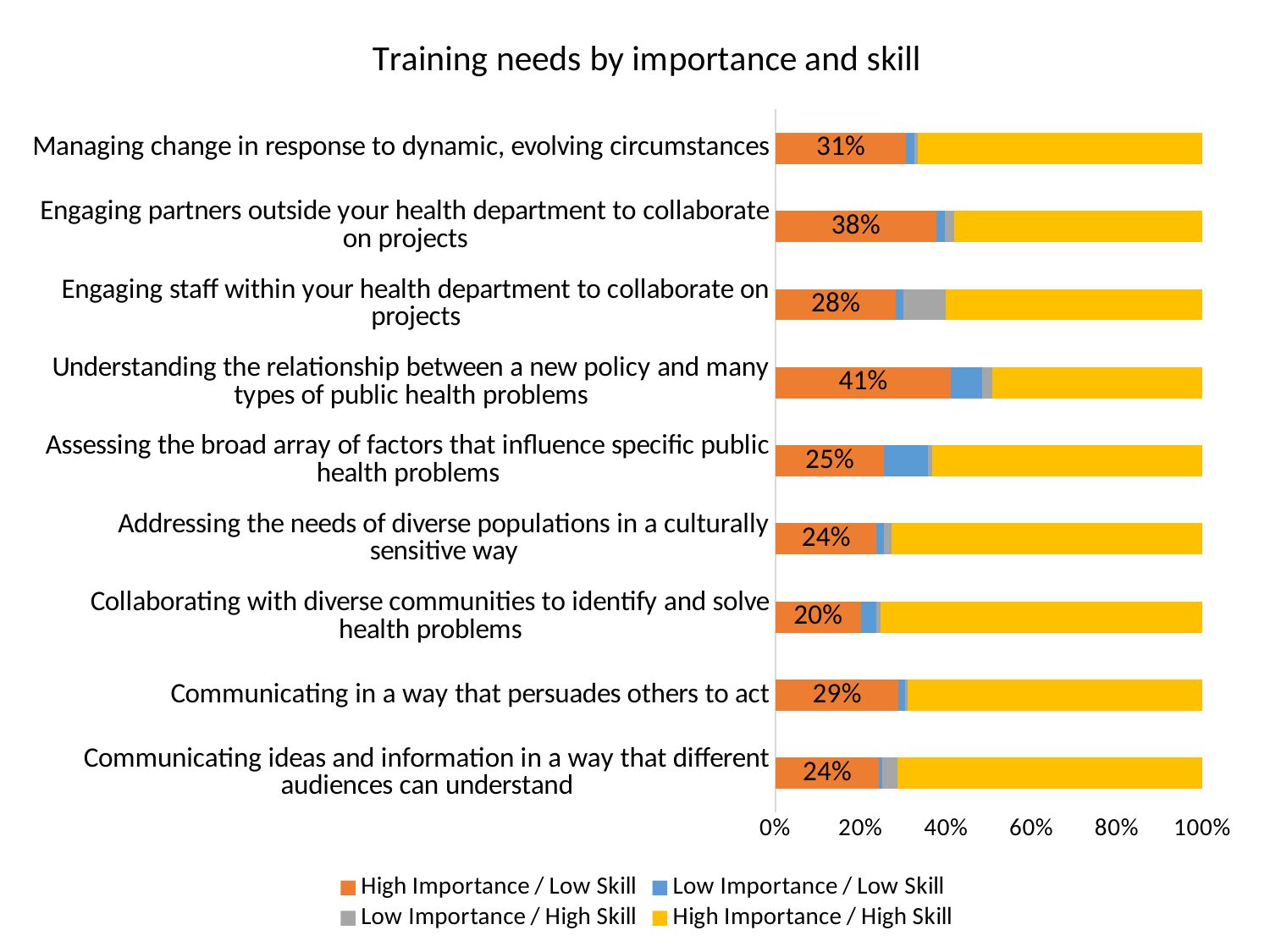
What is the title of the chart? Training needs by importance and skill What is the High Importance / Low Skill value for "Collaborating with diverse communities to identify and solve health problems"? 20% What is the High Importance / Low Skill value for "Understanding the relationship between a new policy and many types of public health problems"? 41% What kind of chart is shown on the slide? Stacked bar chart What is the High Importance / Low Skill value for "Managing change in response to dynamic, evolving circumstances"? 31% Which training need has the highest High Importance / Low Skill percentage? Understanding the relationship between a new policy and many types of public health problems Which training need has the lowest High Importance / Low Skill percentage? Collaborating with diverse communities to identify and solve health problems What is the difference between the highest and lowest High Importance / Low Skill percentages shown? 21% How many series does the legend list? 4 Is the High Importance / High Skill share for "Managing change in response to dynamic, evolving circumstances" greater or less than 60%? greater How many training needs are listed on the chart? 9 Which has a larger High Importance / Low Skill percentage: "Engaging partners outside your health department to collaborate on projects" or "Engaging staff within your health department to collaborate on projects"? Engaging partners outside your health department to collaborate on projects